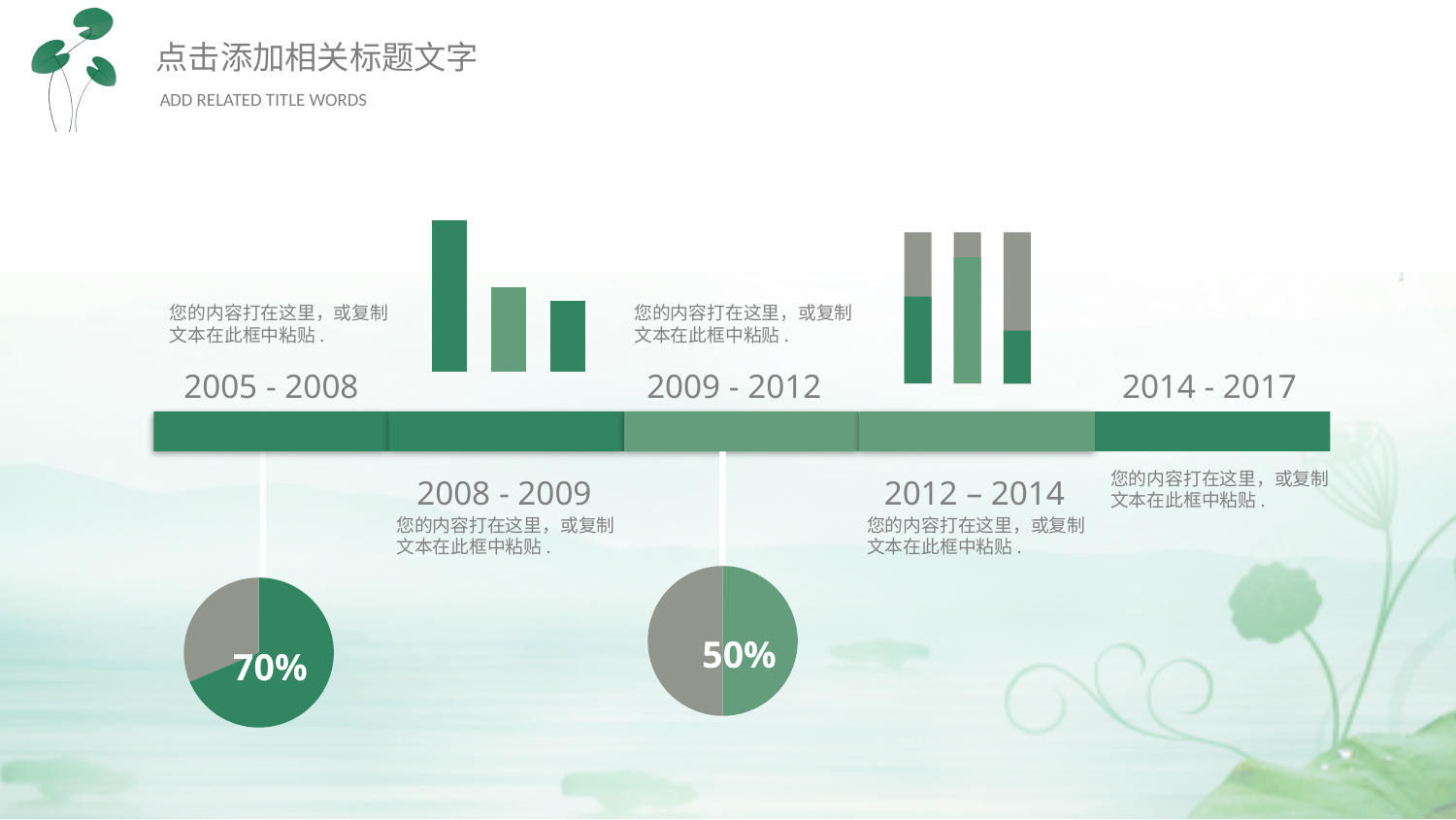
How many bars are in the bar chart at the top of the slide between the 2005 - 2008 and 2009 - 2012 labels? 3 In the stacked bar chart at the top of the slide between the 2009 - 2012 and 2014 - 2017 labels, which bar has the smallest green segment: left, middle or right? right Which pie chart has the larger green share, the one at the bottom left or the one at the bottom centre? bottom left What kind of chart is the chart at the bottom left of the slide, below the 2005 - 2008 label? pie chart In the stacked bar chart at the top of the slide between the 2009 - 2012 and 2014 - 2017 labels, which bar has the largest green segment: left, middle or right? middle In the bar chart at the top of the slide between the 2005 - 2008 and 2009 - 2012 labels, which bar is the tallest: left, middle or right? left In the bar chart at the top of the slide between the 2005 - 2008 and 2009 - 2012 labels, which bar is the shortest: left, middle or right? right What is the difference between the percentage shown on the bottom-left pie chart and the percentage shown on the bottom-centre pie chart? 20% How many bars are in the stacked bar chart at the top of the slide between the 2009 - 2012 and 2014 - 2017 labels? 3 What kind of chart is the chart at the top of the slide between the 2005 - 2008 and 2009 - 2012 labels? bar chart In the pie chart at the bottom left of the slide, what share does the green slice represent? 70% In the pie chart at the bottom centre of the slide, what share does the green slice represent? 50%